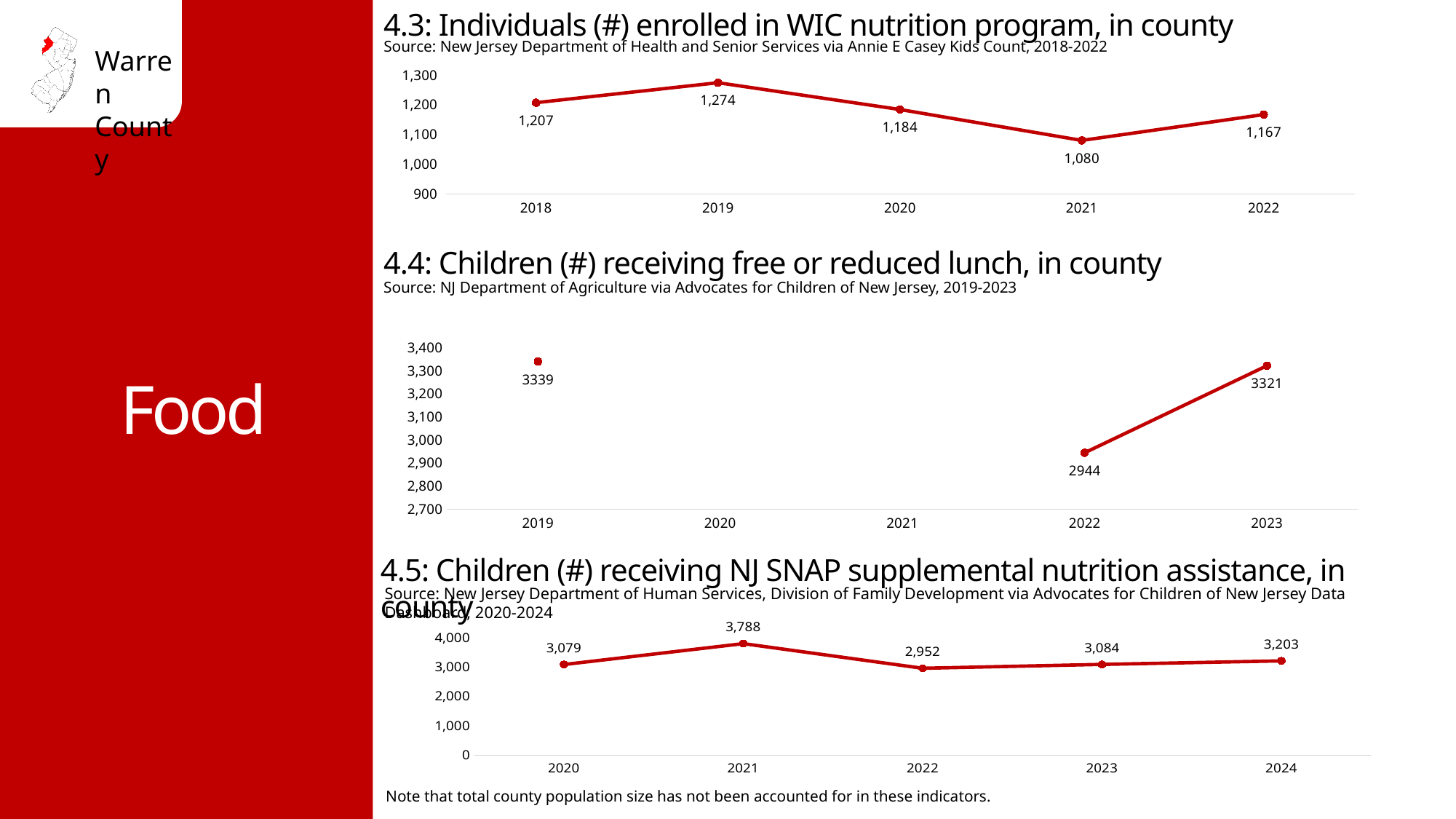
In the chart '4.4: Children (#) receiving free or reduced lunch, in county', what is the difference between the 2023 and 2022 values? 377 In the chart '4.3: Individuals (#) enrolled in WIC nutrition program, in county', how many years are plotted? 5 In the chart '4.3: Individuals (#) enrolled in WIC nutrition program, in county', what is the difference between the 2019 and 2021 values? 194 In the chart '4.5: Children (#) receiving NJ SNAP supplemental nutrition assistance, in county', which year has the lowest value? 2022 In the chart '4.5: Children (#) receiving NJ SNAP supplemental nutrition assistance, in county', do the values rise or fall from 2022 to 2024? rise In the chart '4.3: Individuals (#) enrolled in WIC nutrition program, in county', what is the value for 2019? 1,274 In the chart '4.4: Children (#) receiving free or reduced lunch, in county', is the value for 2019 larger or smaller than the value for 2023? larger What kind of chart is '4.5: Children (#) receiving NJ SNAP supplemental nutrition assistance, in county'? line chart In the chart '4.5: Children (#) receiving NJ SNAP supplemental nutrition assistance, in county', what is the value for 2021? 3,788 In the chart '4.4: Children (#) receiving free or reduced lunch, in county', what is the value for 2022? 2944 In the chart '4.3: Individuals (#) enrolled in WIC nutrition program, in county', which year has the lowest value? 2021 In the chart '4.4: Children (#) receiving free or reduced lunch, in county', which year has the highest value? 2019